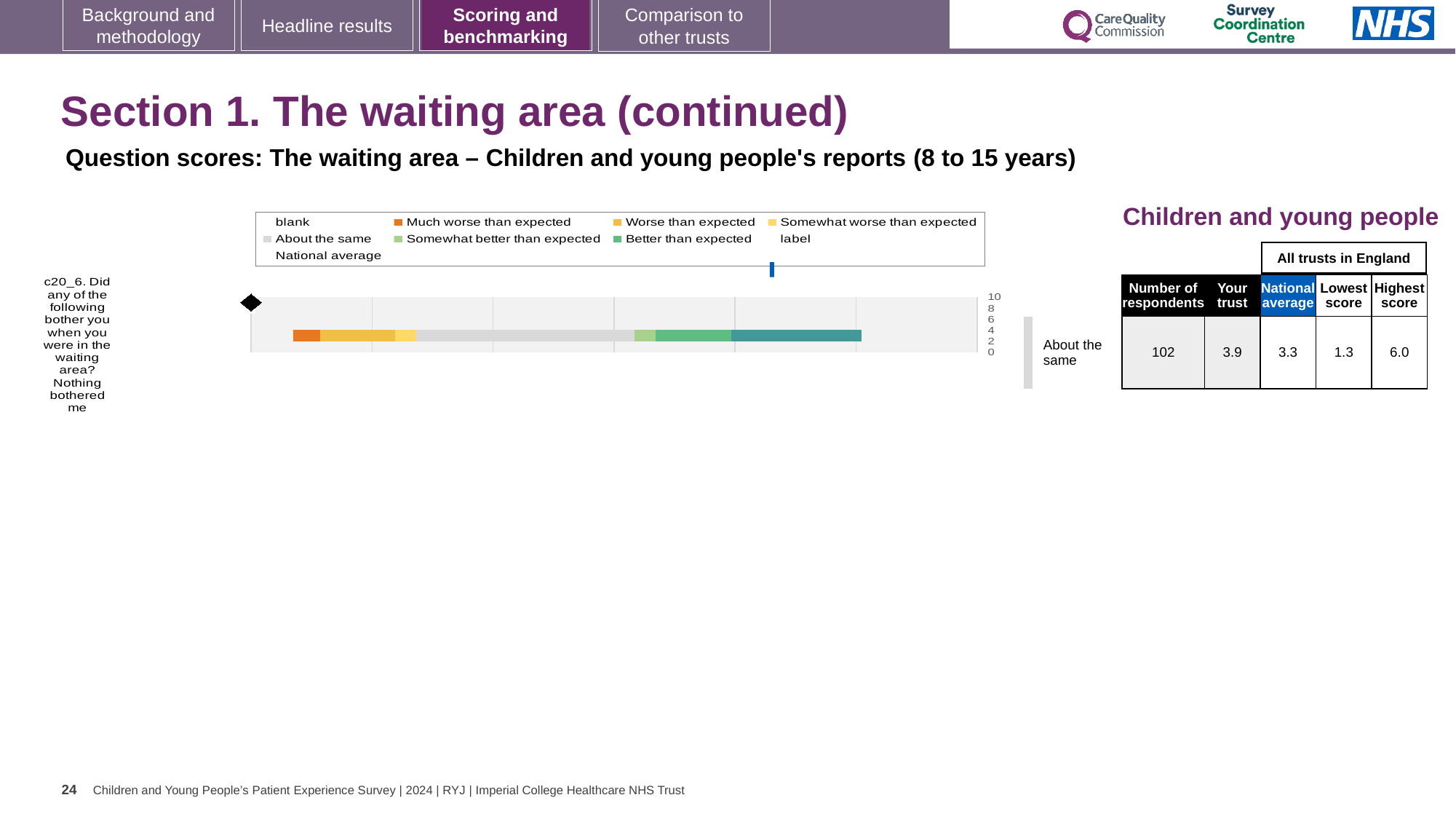
What benchmark category label is shown to the right of the bar for c20_6? About the same According to the table beside the chart, what is the 'Your trust' score for c20_6? 3.9 According to the table beside the chart, what is the national average score for c20_6? 3.3 What is the difference between the highest score and the lowest score among all trusts in England for c20_6? 4.7 According to the table beside the chart, what is the highest score among all trusts in England for c20_6? 6.0 According to the table beside the chart, how many respondents answered c20_6? 102 What kind of chart is used to show the question score for c20_6? bar chart Which is larger for c20_6, the 'Your trust' score or the national average? Your trust What is the difference between the 'Your trust' score and the national average for c20_6? 0.6 How many entries does the chart legend list? 9 What is the highest value shown on the chart's score axis? 10 How many survey questions are plotted on the chart? 1